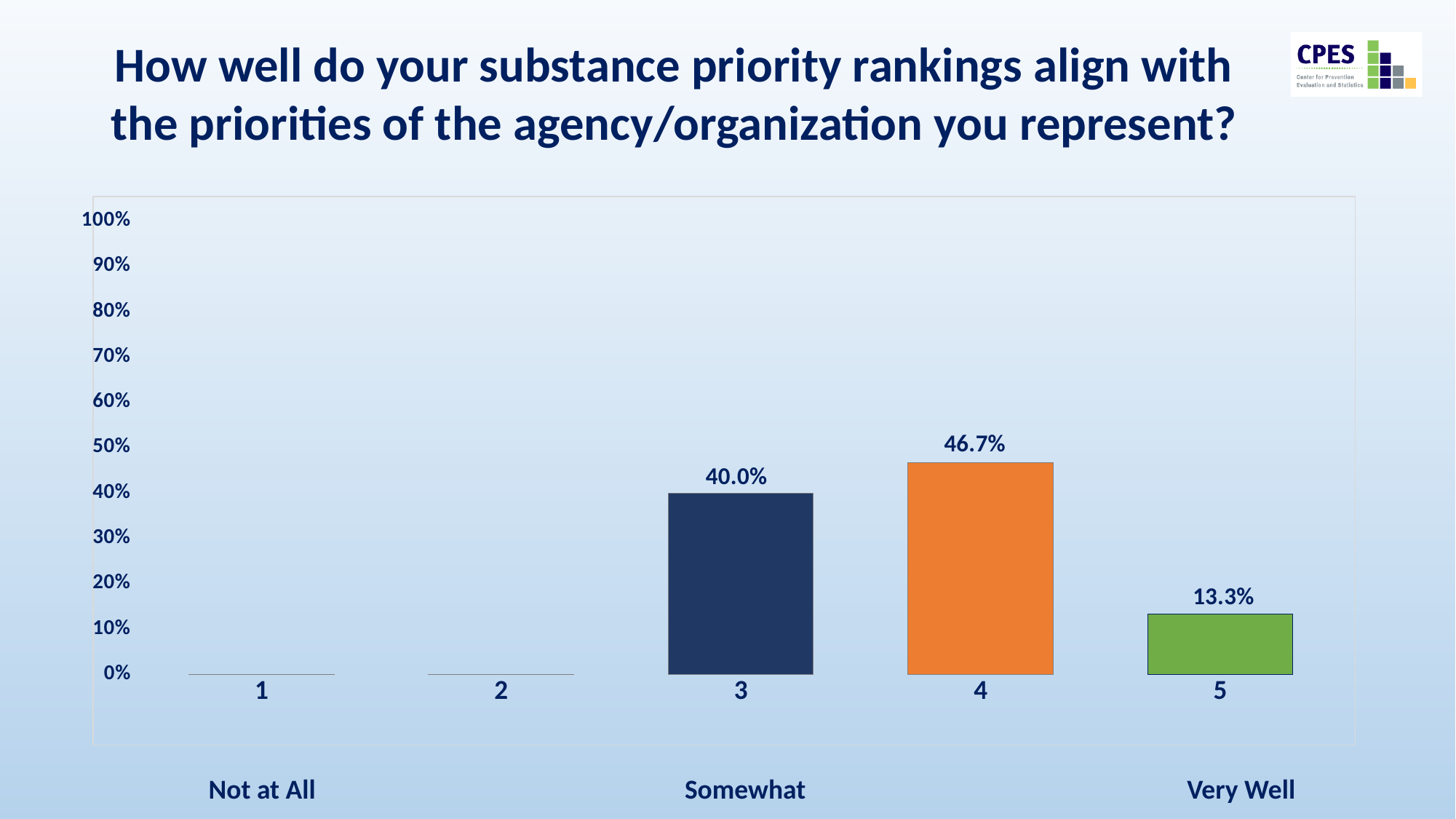
What is the difference in percentage points between rating 4 and rating 3? 6.7% Which rating category has the highest percentage? 4 Is the value for rating 4 greater or less than 50%? less How many rating categories are shown on the x axis? 5 What is the difference in percentage points between rating 3 and rating 5? 26.7% What colour is the bar for rating 4? orange What percentage of respondents chose rating 4? 46.7% What kind of chart is shown on the slide? bar chart Which rating category has the lowest non-zero percentage? 5 What percentage of respondents chose rating 5 (Very Well)? 13.3% Which has a larger percentage, rating 3 or rating 5? 3 What percentage of respondents chose rating 3? 40.0%